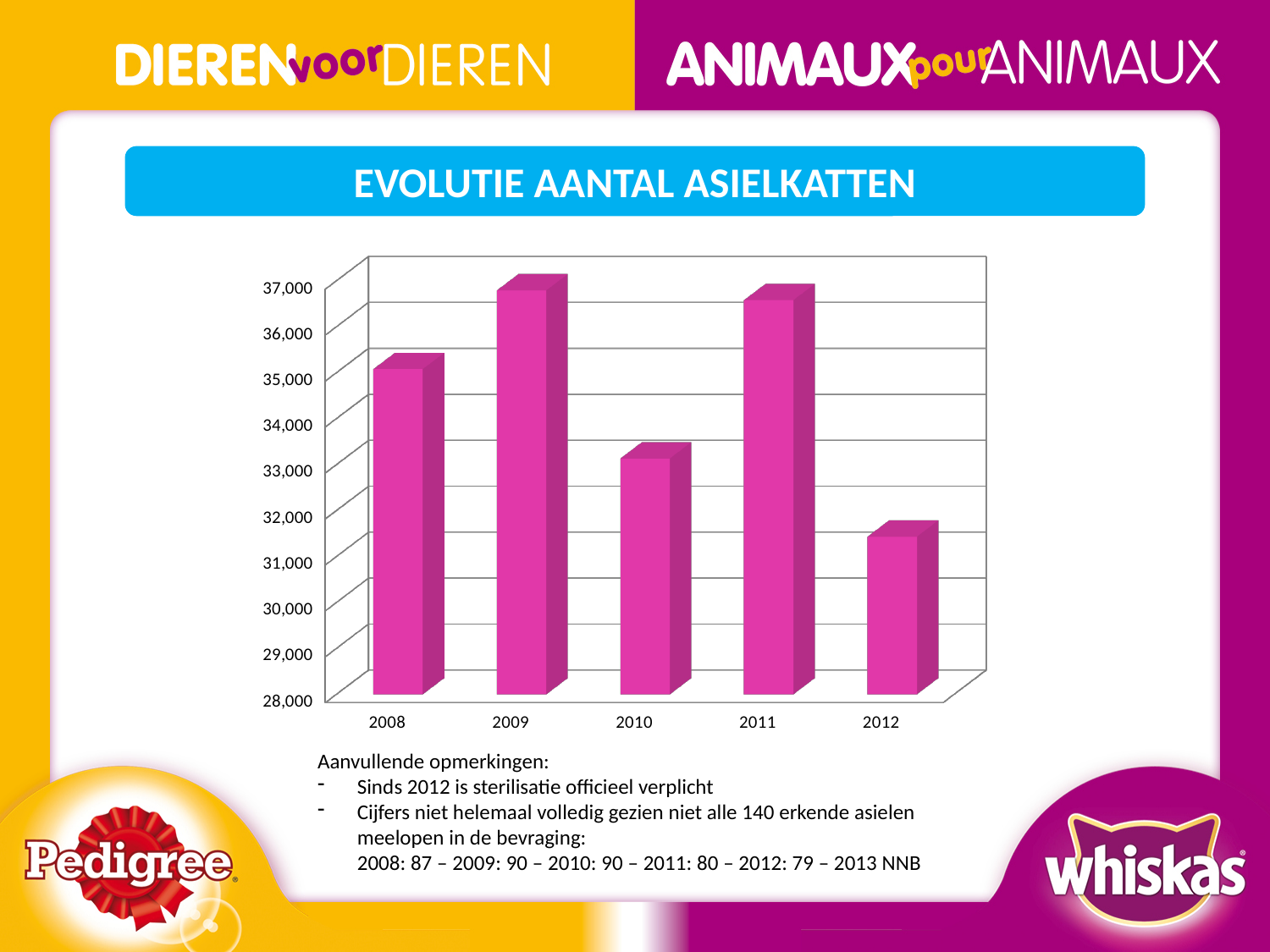
Which is larger, the value for 2008 or the value for 2010? 2008 How many years are shown on the x axis of the chart? 5 Is the value for 2009 greater or less than 36,000? greater Is the value for 2011 greater or less than 36,000? greater Did the value rise or fall from 2011 to 2012? fall Is the value for 2012 greater or less than 32,000? less What is the title of the chart? EVOLUTIE AANTAL ASIELKATTEN Which year has the lowest value in the chart? 2012 What is the lowest value shown on the vertical axis of the chart? 28,000 What kind of chart is shown on the slide? Bar chart